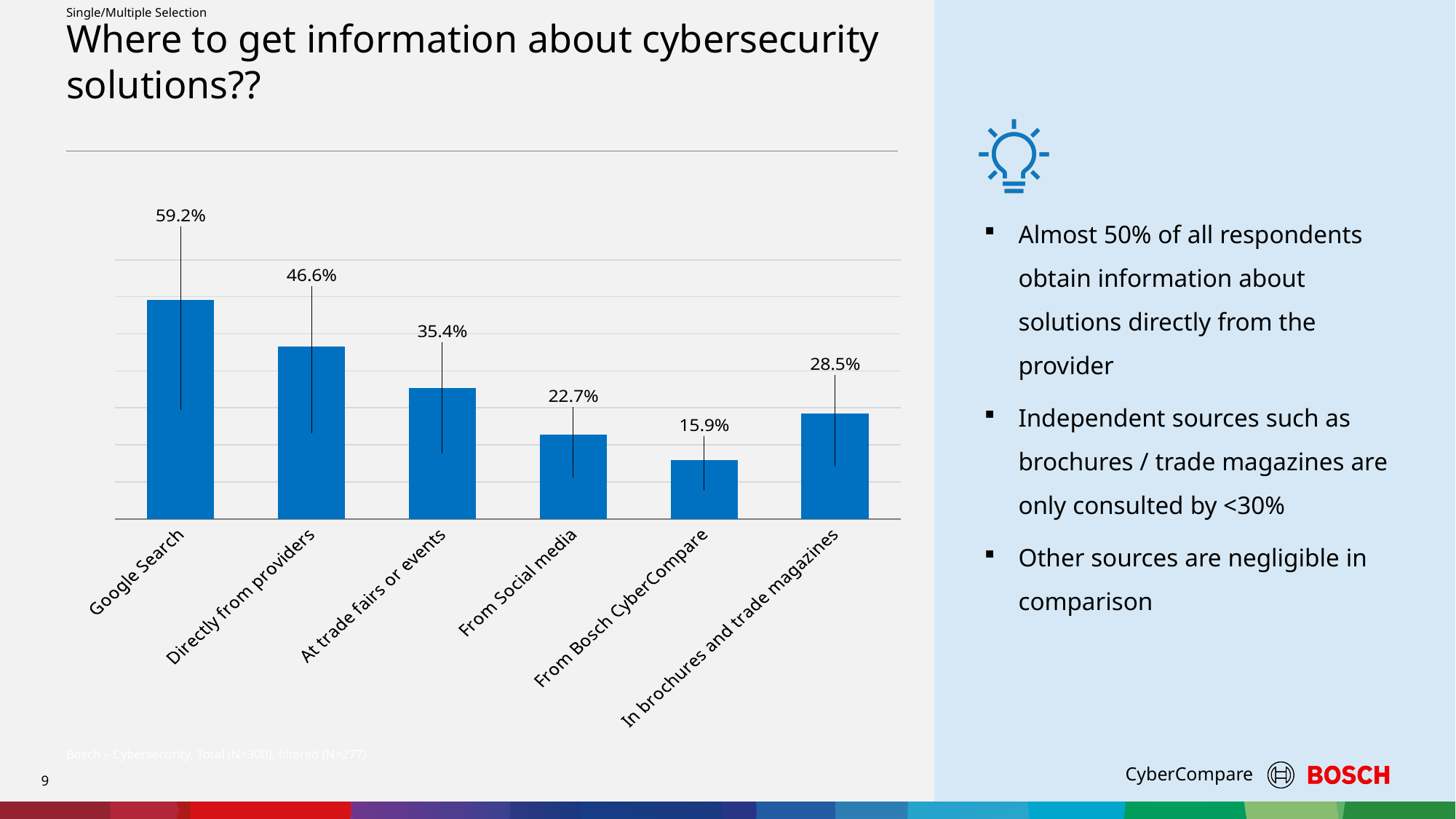
What is the difference between At trade fairs or events and From Social media? 12.7% What is the value for Google Search? 59.2% What is the difference between Google Search and Directly from providers? 12.6% Which category has the lowest value? From Bosch CyberCompare What kind of chart is shown on the slide? Bar chart How many categories are shown in the chart? 6 What is the value for In brochures and trade magazines? 28.5% Which is larger, From Social media or In brochures and trade magazines? In brochures and trade magazines What is the value for From Bosch CyberCompare? 15.9% What is the value for At trade fairs or events? 35.4% What is the value for Directly from providers? 46.6% Which category has the highest value? Google Search